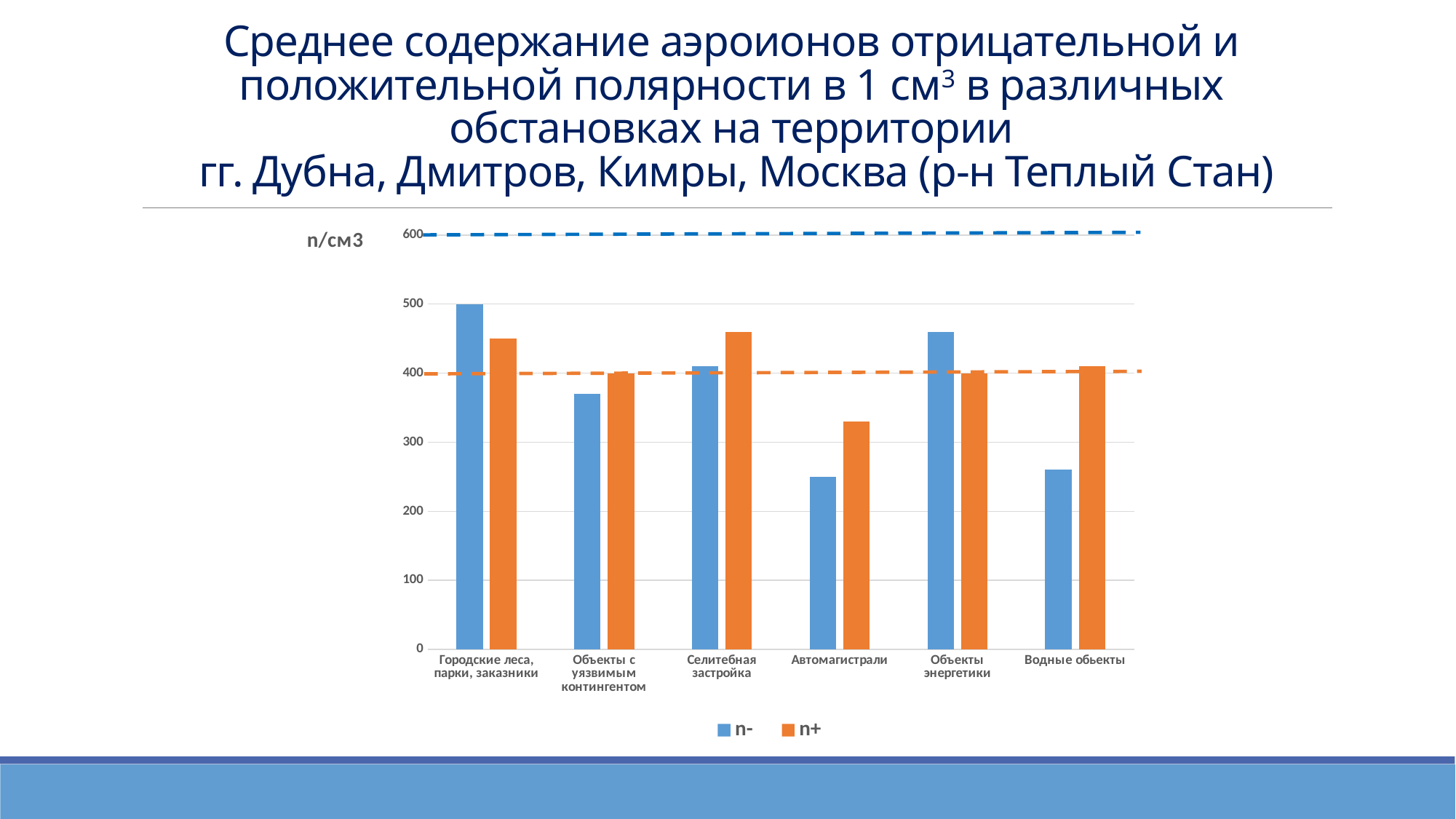
Is the n- value for Автомагистрали greater or less than 300? less Which category has the highest n- value? Городские леса, парки, заказники Is the n- value for Объекты энергетики greater or less than 400? greater How many series does the chart legend list? 2 What is the n- value for Городские леса, парки, заказники? 500 What kind of chart is shown on the slide? bar chart What are the two series named in the legend? n- and n+ For Городские леса, парки, заказники, which is larger, n- or n+? n- For Водные объекты, which is larger, n- or n+? n+ How many categories are shown on the x axis of the chart? 6 Which category has the lowest n+ value? Автомагистрали What unit label is shown next to the vertical axis? n/см3